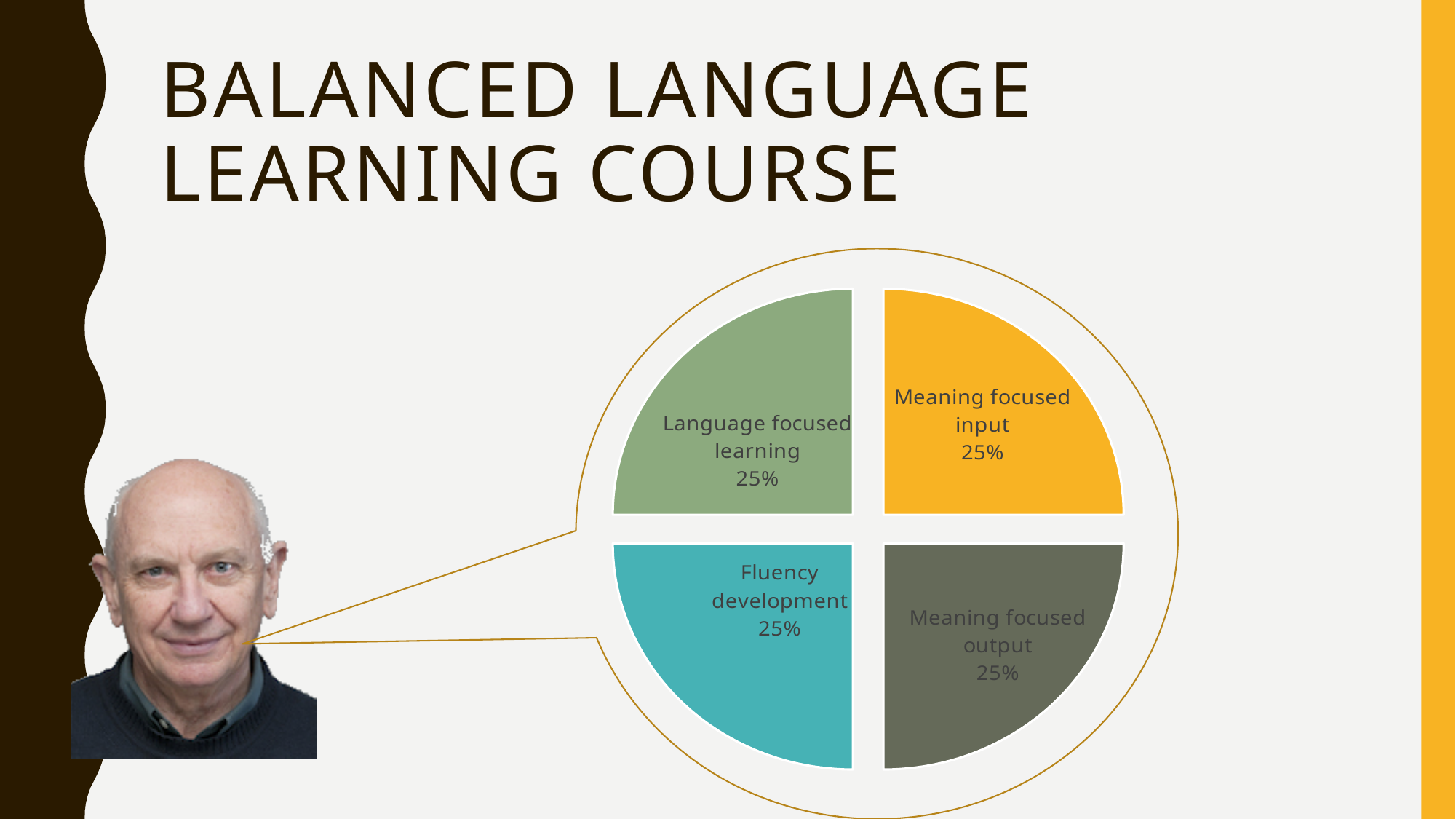
What is the value shown for Language focused learning? 25% What is the value shown for Meaning focused output? 25% What is the difference between the values for Meaning focused input and Meaning focused output? 0% What share of the pie does the Fluency development slice represent? 25% What colour is the Meaning focused input slice? Orange What is the value shown for Fluency development? 25% What is the value shown for Meaning focused input? 25% What colour is the Fluency development slice? Teal Do all four slices of the pie chart have the same value? Yes What kind of chart is shown on the slide? pie chart How many slices does the pie chart have? 4